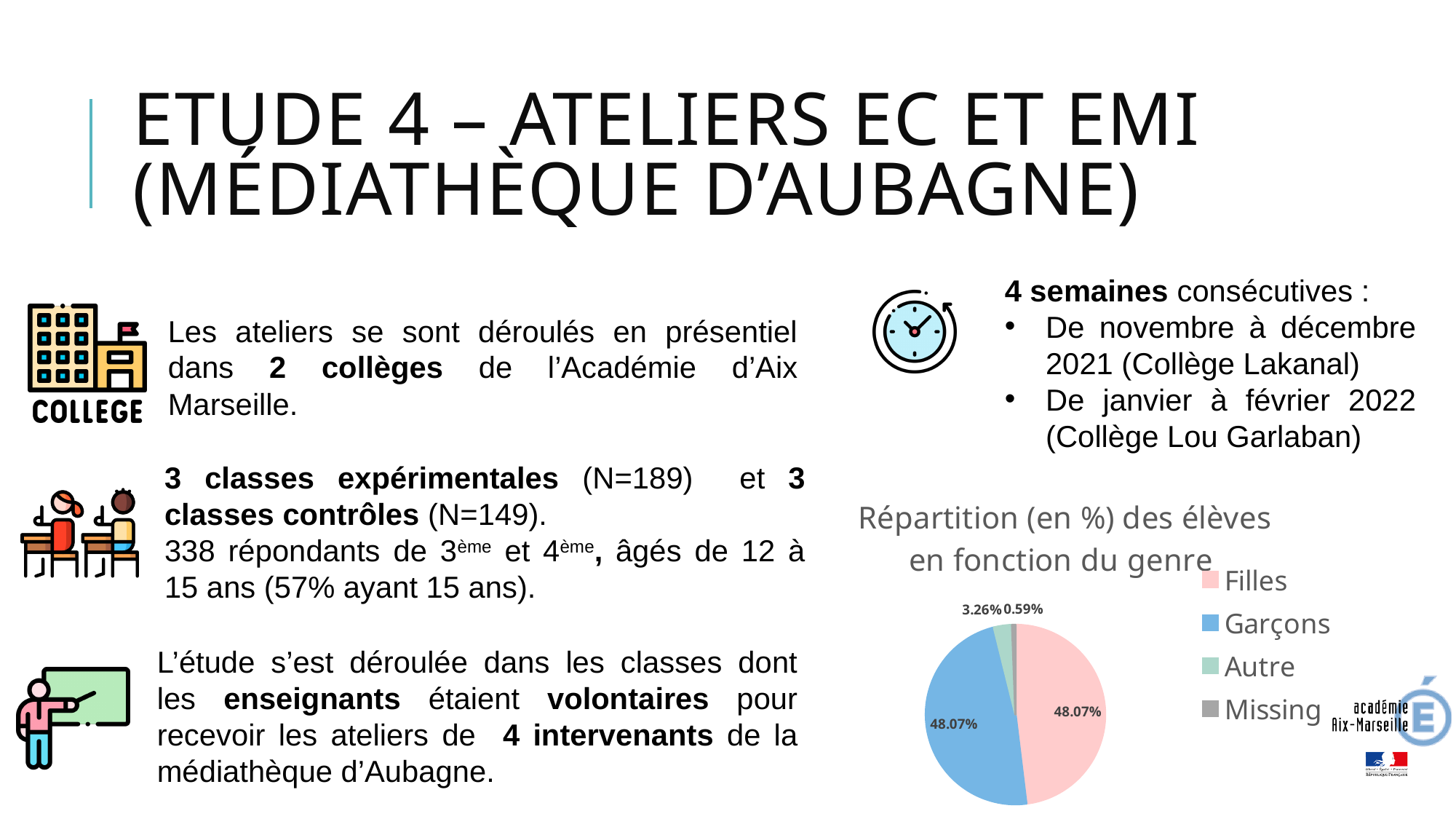
What is the title of the chart on the slide? Répartition (en %) des élèves en fonction du genre What value is shown for Missing in the pie chart? 0.59% What value is shown for Autre in the pie chart? 3.26% What kind of chart is shown on the slide? pie chart What percentage of the pie chart is the Filles slice? 48.07% Which category has the smallest slice in the pie chart? Missing Which slice is larger in the pie chart, Autre or Missing? Autre How many categories does the pie chart show? 4 How many entries does the legend of the pie chart list? 4 What is the difference between the Filles and Autre values in the pie chart? 44.81% What is the difference between the Autre and Missing values in the pie chart? 2.67% What value is shown for Garçons in the pie chart? 48.07%